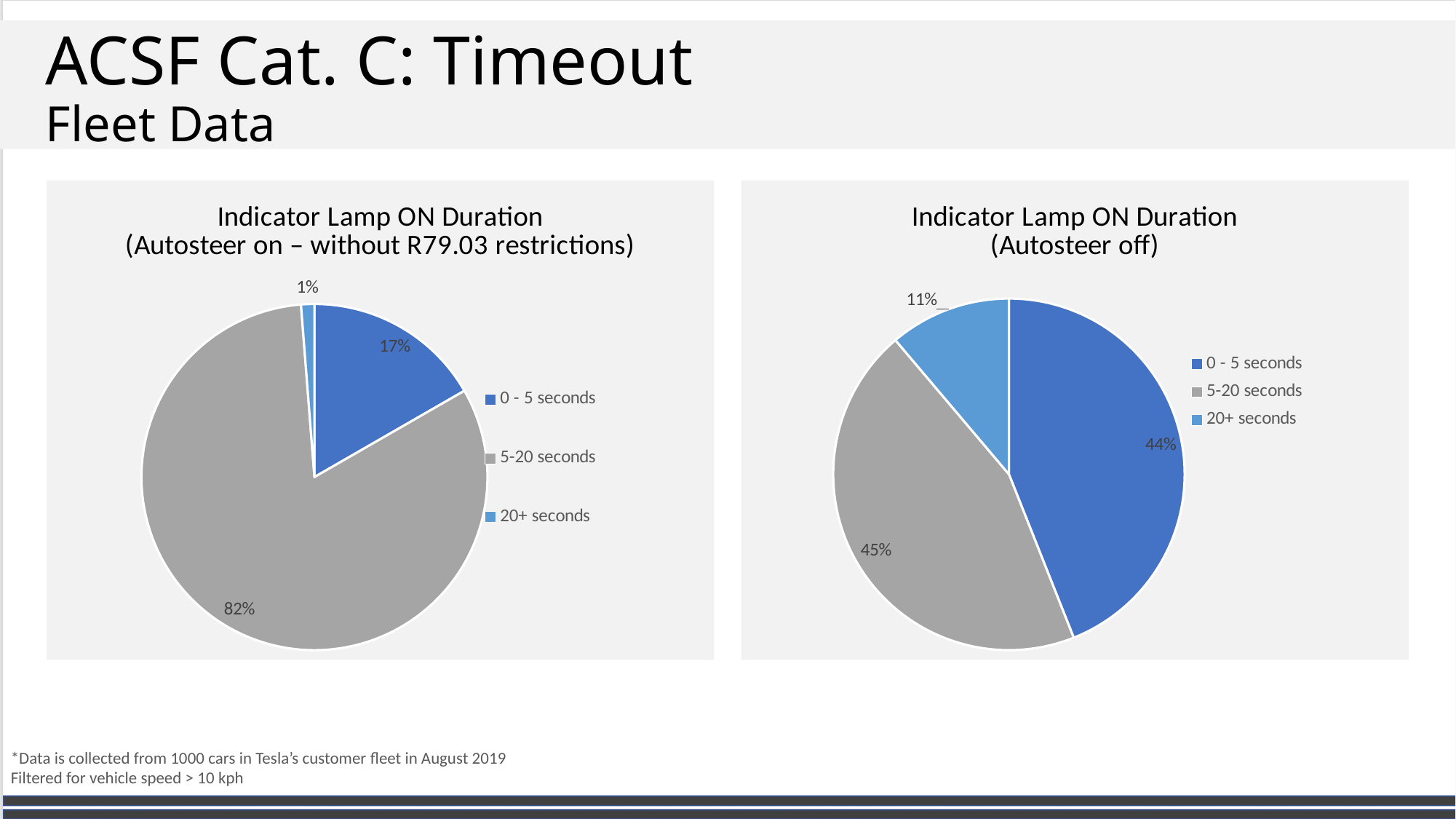
In the right chart (Autosteer off), which category has the smallest slice? 20+ seconds In the left chart (Autosteer on – without R79.03 restrictions), what is the difference between the 5-20 seconds and 0 - 5 seconds shares? 65% In the right chart (Autosteer off), which is larger: the 5-20 seconds slice or the 20+ seconds slice? 5-20 seconds In the left chart (Autosteer on – without R79.03 restrictions), which category has the largest slice? 5-20 seconds In the right chart (Autosteer off), what is the value for 0 - 5 seconds? 44% In the left chart (Autosteer on – without R79.03 restrictions), which category has the smallest slice? 20+ seconds In the left chart (Autosteer on – without R79.03 restrictions), what is the value for 0 - 5 seconds? 17% In the right chart (Autosteer off), what is the value for 20+ seconds? 11% In the left chart (Autosteer on – without R79.03 restrictions), what share of the pie is 5-20 seconds? 82% What kind of chart is the left chart (Autosteer on – without R79.03 restrictions)? Pie chart In the left chart (Autosteer on – without R79.03 restrictions), what is the value for 20+ seconds? 1% How many categories does the legend of the right chart (Autosteer off) list? 3